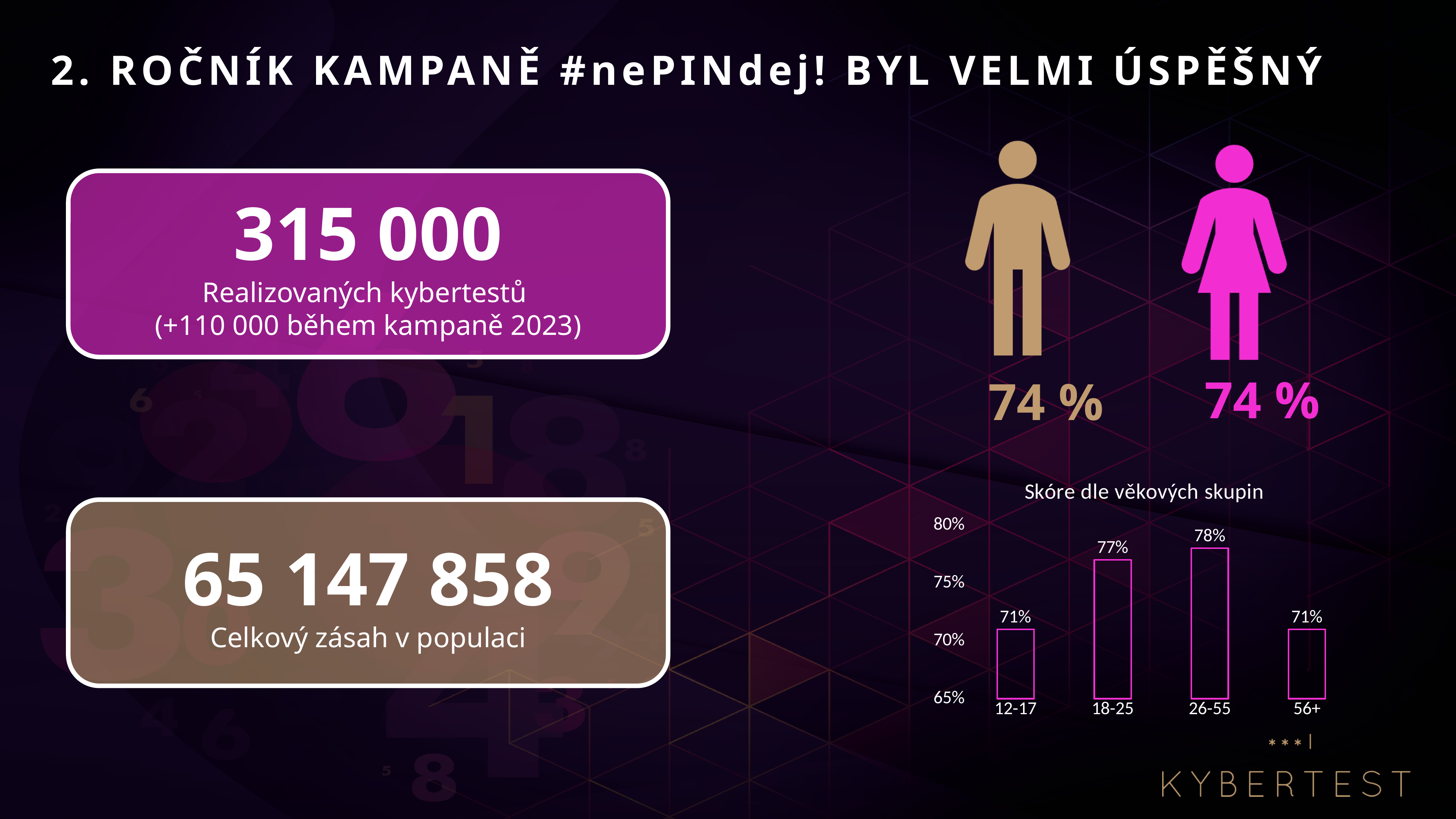
Which age group has the highest score in the 'Skóre dle věkových skupin' chart? 26-55 Is the value for the 18-25 age group in the 'Skóre dle věkových skupin' chart greater or less than 75%? greater What is the value for the 56+ age group in the 'Skóre dle věkových skupin' chart? 71% How many age groups are shown in the 'Skóre dle věkových skupin' chart? 4 What is the value for the 18-25 age group in the 'Skóre dle věkových skupin' chart? 77% What is the title of the chart on the slide? Skóre dle věkových skupin What kind of chart is 'Skóre dle věkových skupin'? bar chart What is the value for the 12-17 age group in the 'Skóre dle věkových skupin' chart? 71% In the 'Skóre dle věkových skupin' chart, which has a higher score: 18-25 or 56+? 18-25 What is the value for the 26-55 age group in the 'Skóre dle věkových skupin' chart? 78% What is the difference between the scores of the 18-25 and 56+ age groups in the 'Skóre dle věkových skupin' chart? 6% What is the difference between the scores of the 26-55 and 12-17 age groups in the 'Skóre dle věkových skupin' chart? 7%